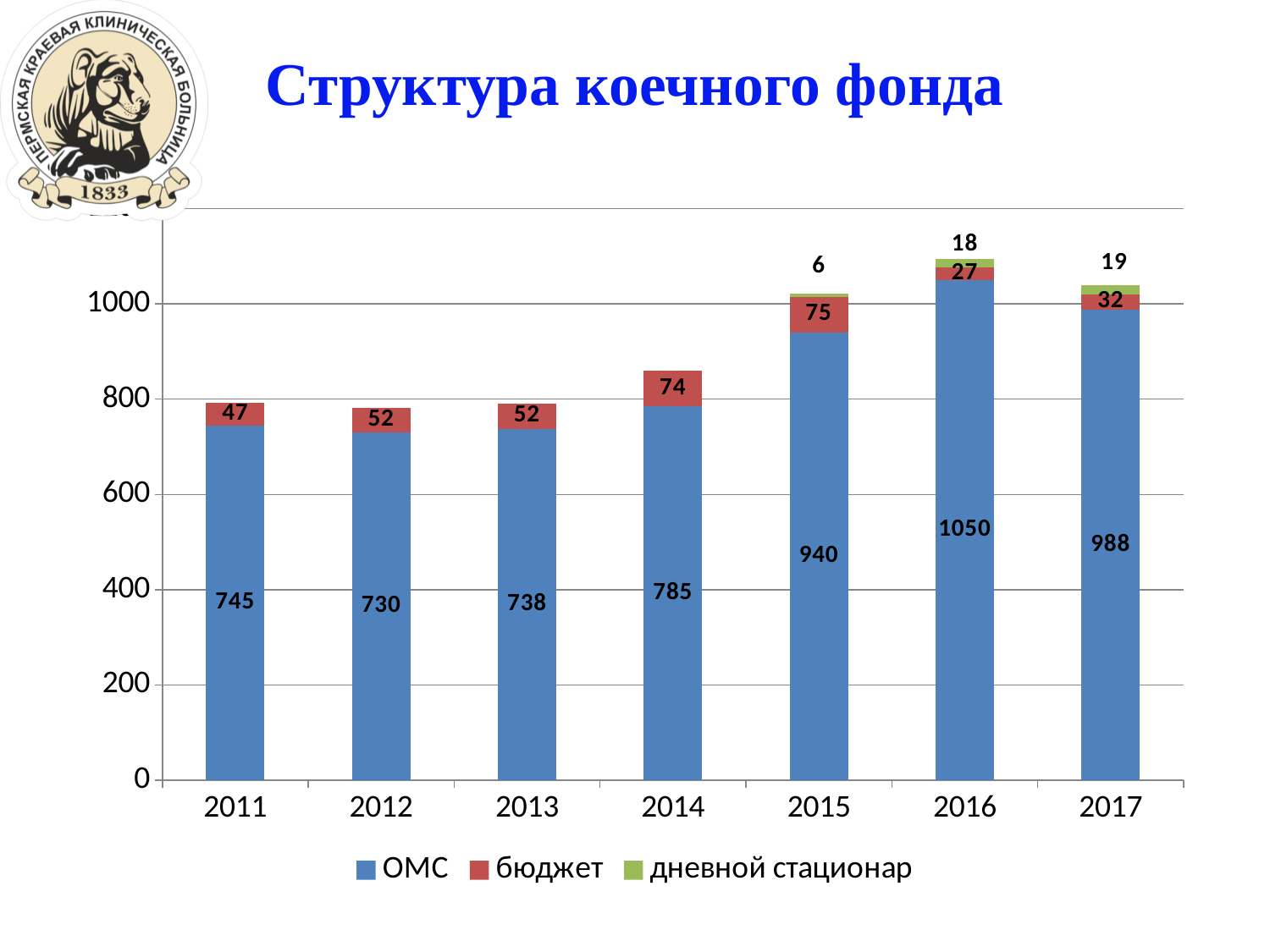
What type of chart is shown on the slide? Stacked bar chart What is the total of the stacked bar for 2015? 1021 Which year has the highest ОМС value? 2016 Which is larger, the бюджет value for 2015 or for 2016? 2015 What is the difference between the ОМС values for 2016 and 2017? 62 What is the бюджет value for 2014? 74 What is the total of the stacked bar for 2011? 792 How many series does the legend list? 3 What is the ОМС value for 2016? 1050 How many years are shown on the x axis? 7 Which year has the lowest ОМС value? 2012 What is the дневной стационар value for 2017? 19